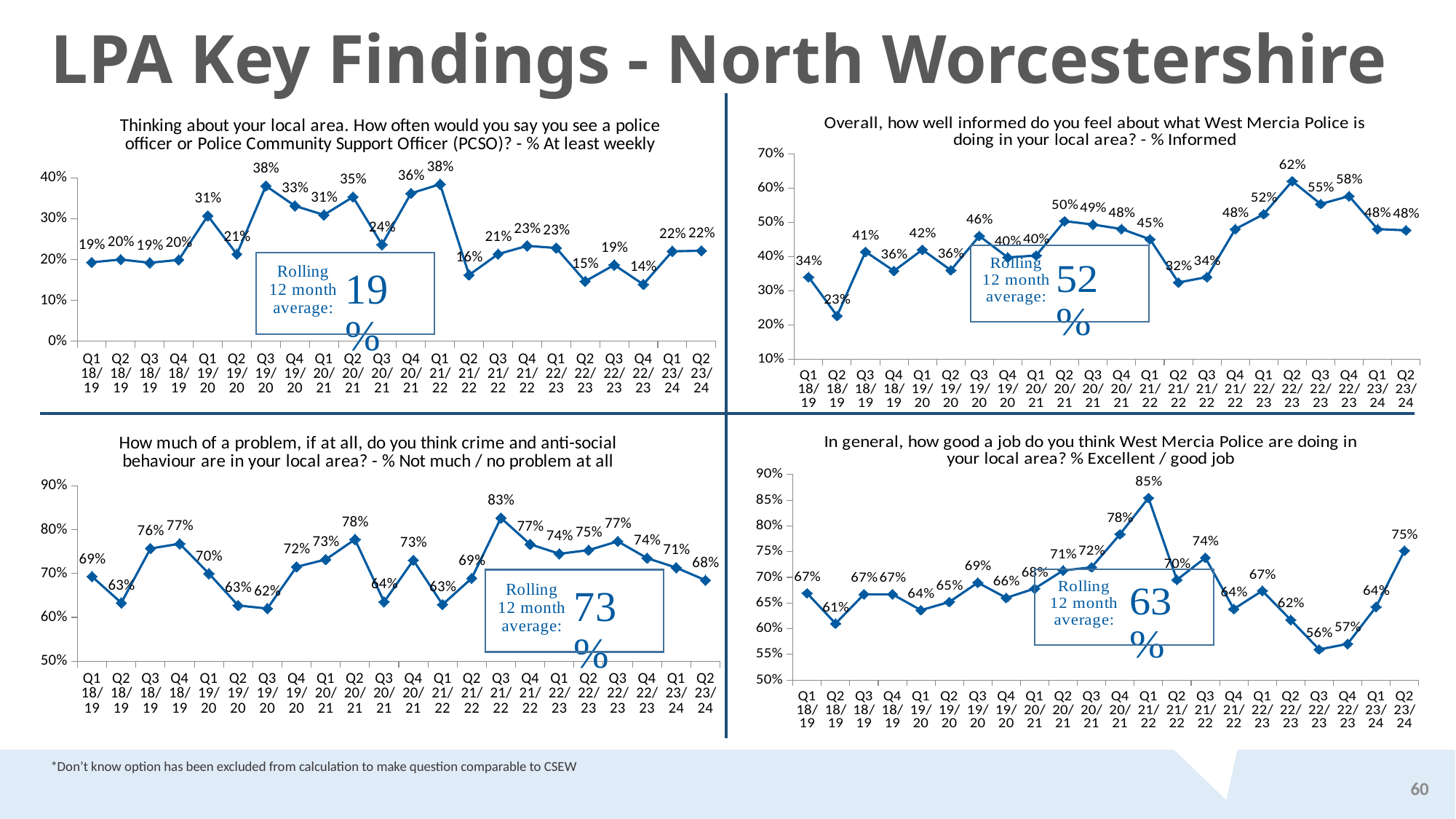
In the top-right chart (% Informed), which quarter has the highest value? Q2 22/23 How many quarterly data points are plotted in the top-left chart (% At least weekly)? 22 In the top-right chart (% Informed), what is the difference between the Q2 22/23 value and the Q2 18/19 value? 39% In the bottom-left chart (% Not much / no problem at all), what is the value for Q3 21/22? 83% In the top-right chart (% Informed), what is the value for Q2 18/19? 23% In the bottom-right chart (% Excellent / good job), what is the value for Q1 21/22? 85% In the top-left chart (% At least weekly), which quarter has the lowest value? Q4 22/23 In the bottom-left chart (% Not much / no problem at all), which quarter has the lowest value? Q3 19/20 In the bottom-right chart (% Excellent / good job), what is the difference between the Q1 21/22 value and the Q3 22/23 value? 29% In the bottom-right chart (% Excellent / good job), which is larger, the value for Q2 23/24 or the value for Q3 22/23? Q2 23/24 In the top-left chart (% At least weekly), what is the value for Q3 19/20? 38% What type of chart is used for the bottom-left chart (% Not much / no problem at all)? Line chart